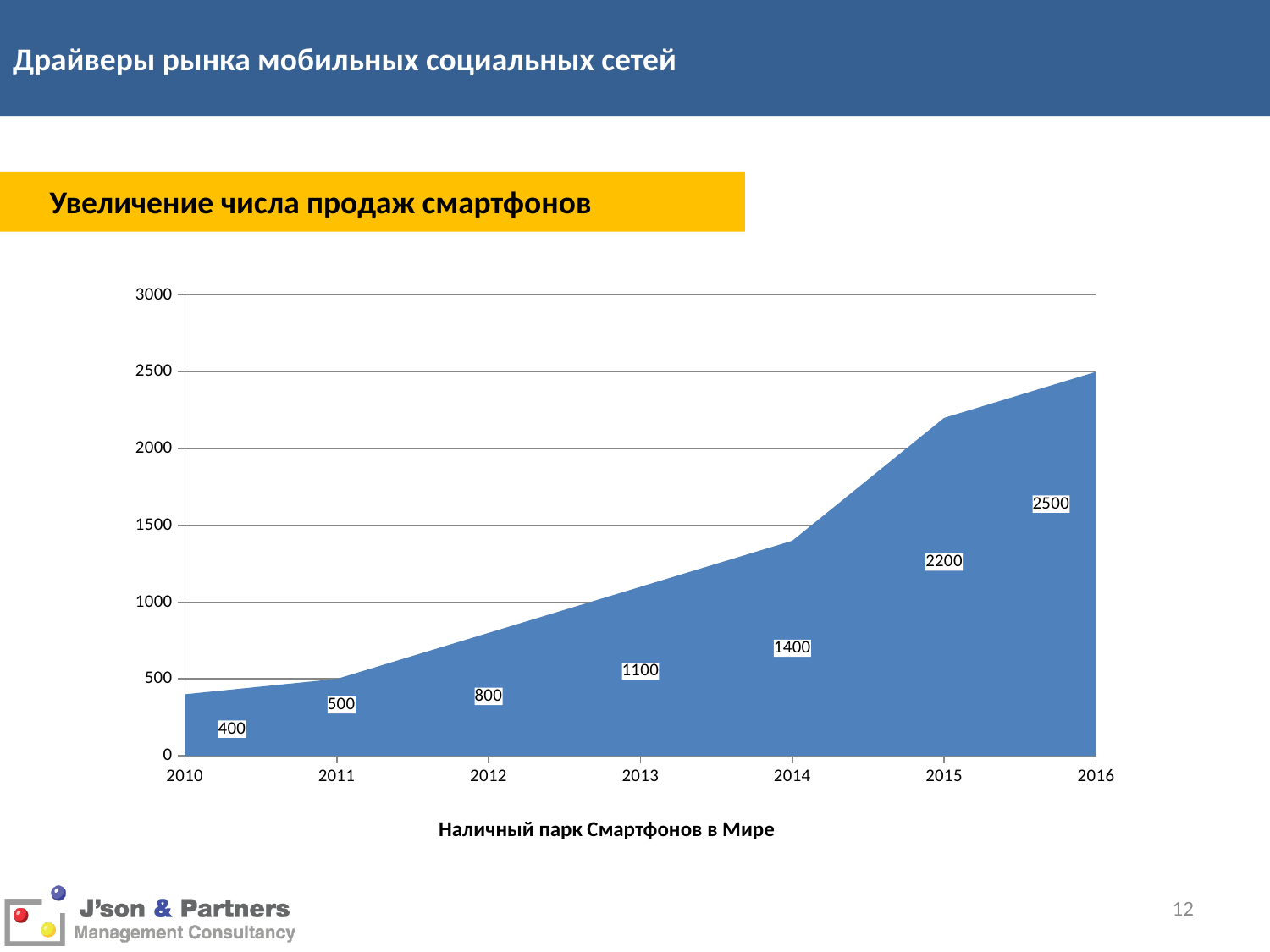
What is the value for 2015? 2200 What is the difference between the values for 2014 and 2012? 600 Which is larger, the value for 2012 or the value for 2011? 2012 Is the value for 2014 greater or less than 1500? less How many years are plotted on the chart? 7 What is the value for 2013? 1100 What is the value for 2010? 400 What is the difference between the values for 2016 and 2015? 300 Which year has the highest value? 2016 What kind of chart is shown? area chart Which year has the lowest value? 2010 Do the values rise or fall from 2010 to 2016? rise